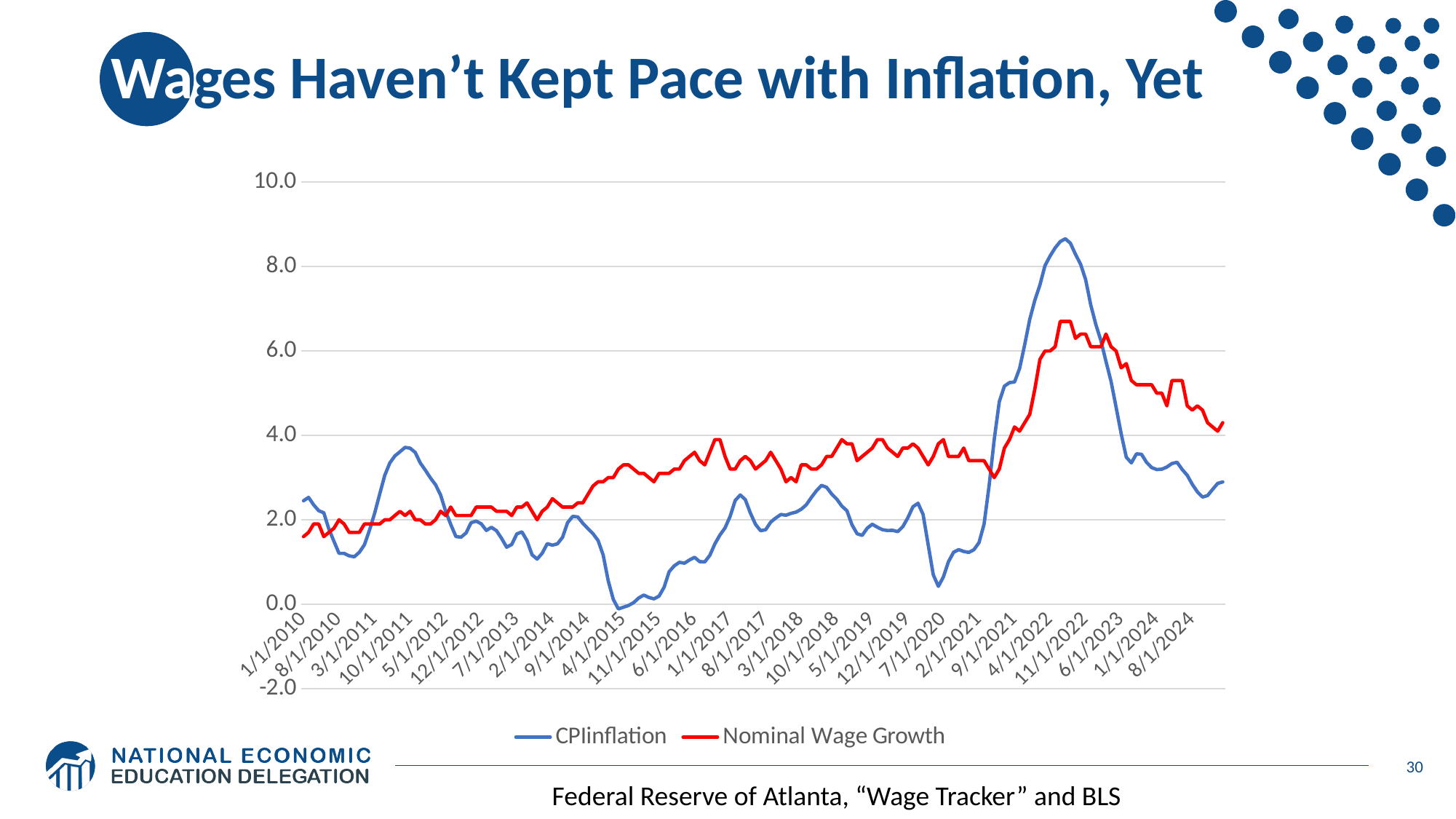
Is the value of CPIinflation at 8/1/2024 greater or less than 4.0? less Which series reaches the lowest value on the chart? CPIinflation Is the peak value of Nominal Wage Growth around 2022 greater or less than 6.0? greater Does CPIinflation rise or fall between 4/1/2022 and 6/1/2023? fall How many series does the legend list? 2 At 1/1/2024, which series has the higher value, CPIinflation or Nominal Wage Growth? Nominal Wage Growth Which series reaches the highest peak on the chart? CPIinflation Is the peak value of CPIinflation around 2022 greater or less than 8.0? greater Which series is drawn in red? Nominal Wage Growth What kind of chart is shown on the slide? Line chart What is the title of the slide's chart? Wages Haven't Kept Pace with Inflation, Yet